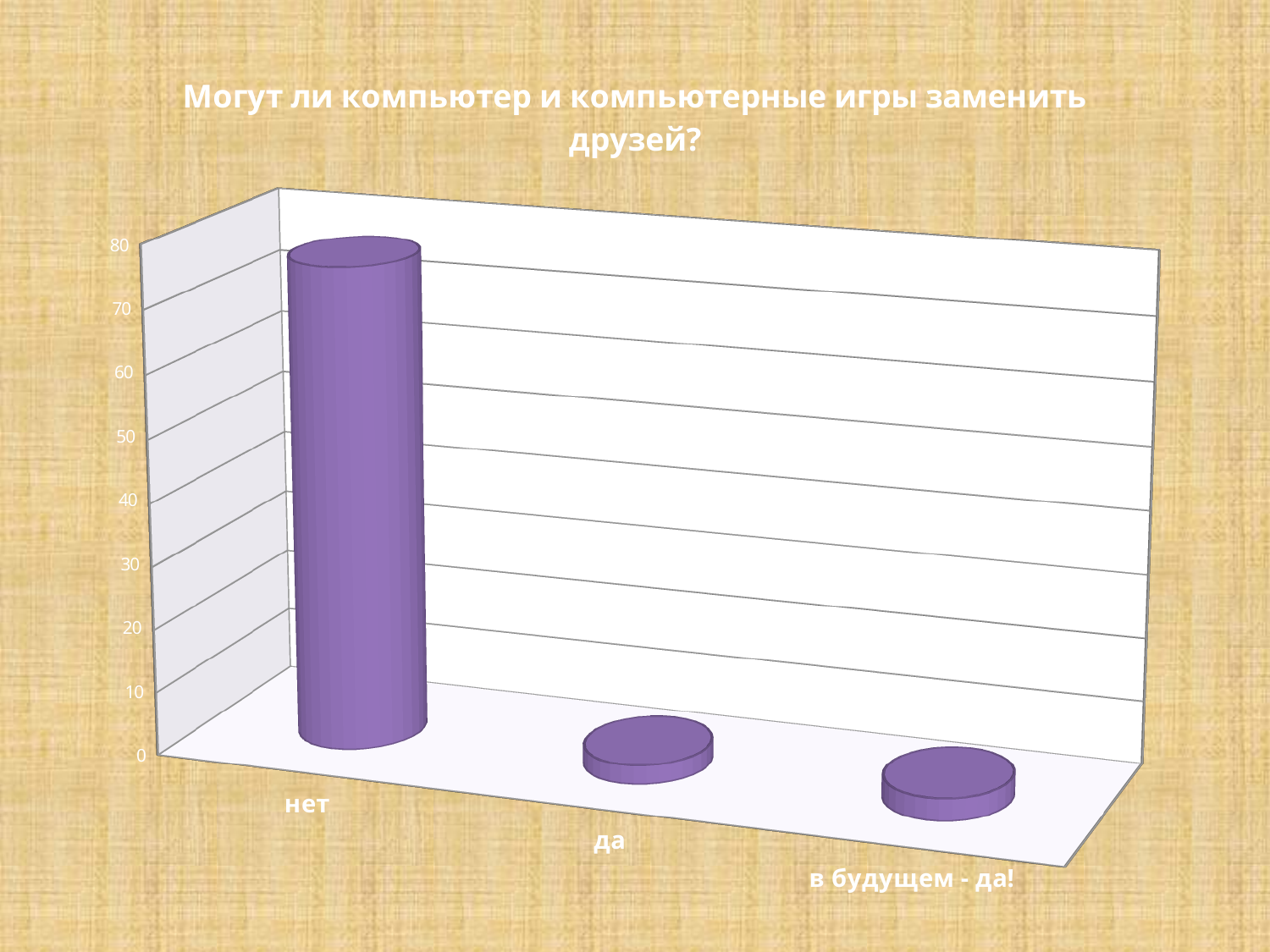
What kind of chart is shown on the slide? bar chart Is the value for "в будущем - да!" greater or less than 10? less Is the value for "нет" greater or less than 60? greater Which is larger, the value for "нет" or the value for "в будущем - да!"? нет Is the value for "да" greater or less than 20? less Which category has the highest value in the chart? нет What is the highest value shown on the vertical axis of the chart? 80 What is the title of the chart? Могут ли компьютер и компьютерные игры заменить друзей? Which is larger, the value for "нет" or the value for "да"? нет How many categories are shown on the x axis of the chart? 3